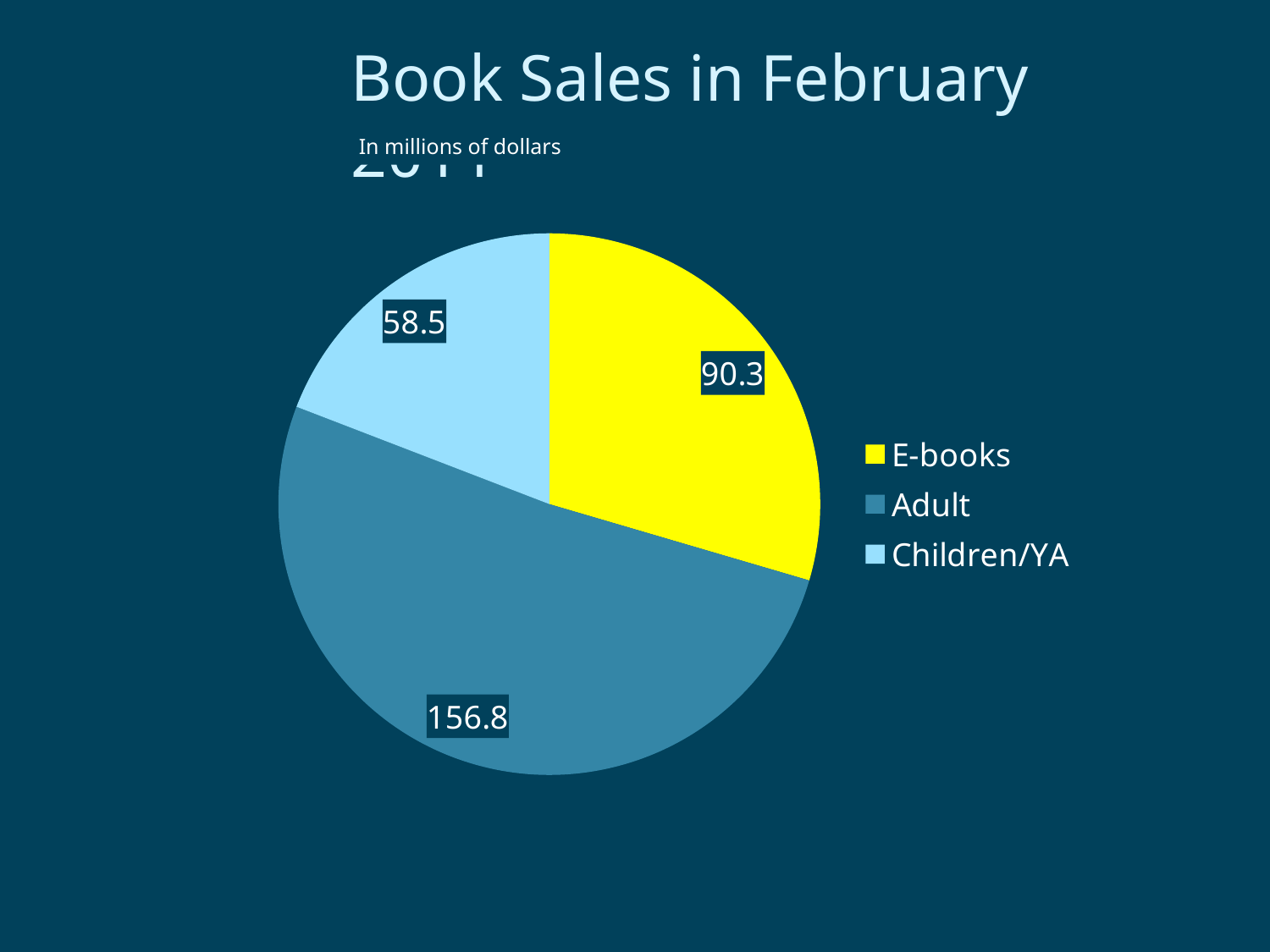
What is the difference between the E-books and Children/YA values? 31.8 What is the value for E-books in the pie chart? 90.3 Which category has the smallest slice of the pie? Children/YA Which category has the largest slice of the pie? Adult How many categories does the pie chart show? 3 What is the title of the chart? Book Sales in February Which is larger, the value for E-books or the value for Children/YA? E-books What kind of chart is shown on the slide? Pie chart What is the difference between the Adult and E-books values? 66.5 What is the value for Children/YA in the pie chart? 58.5 What is the value for Adult in the pie chart? 156.8 What share of the pie does the Adult slice represent, to one decimal place? 51.3%